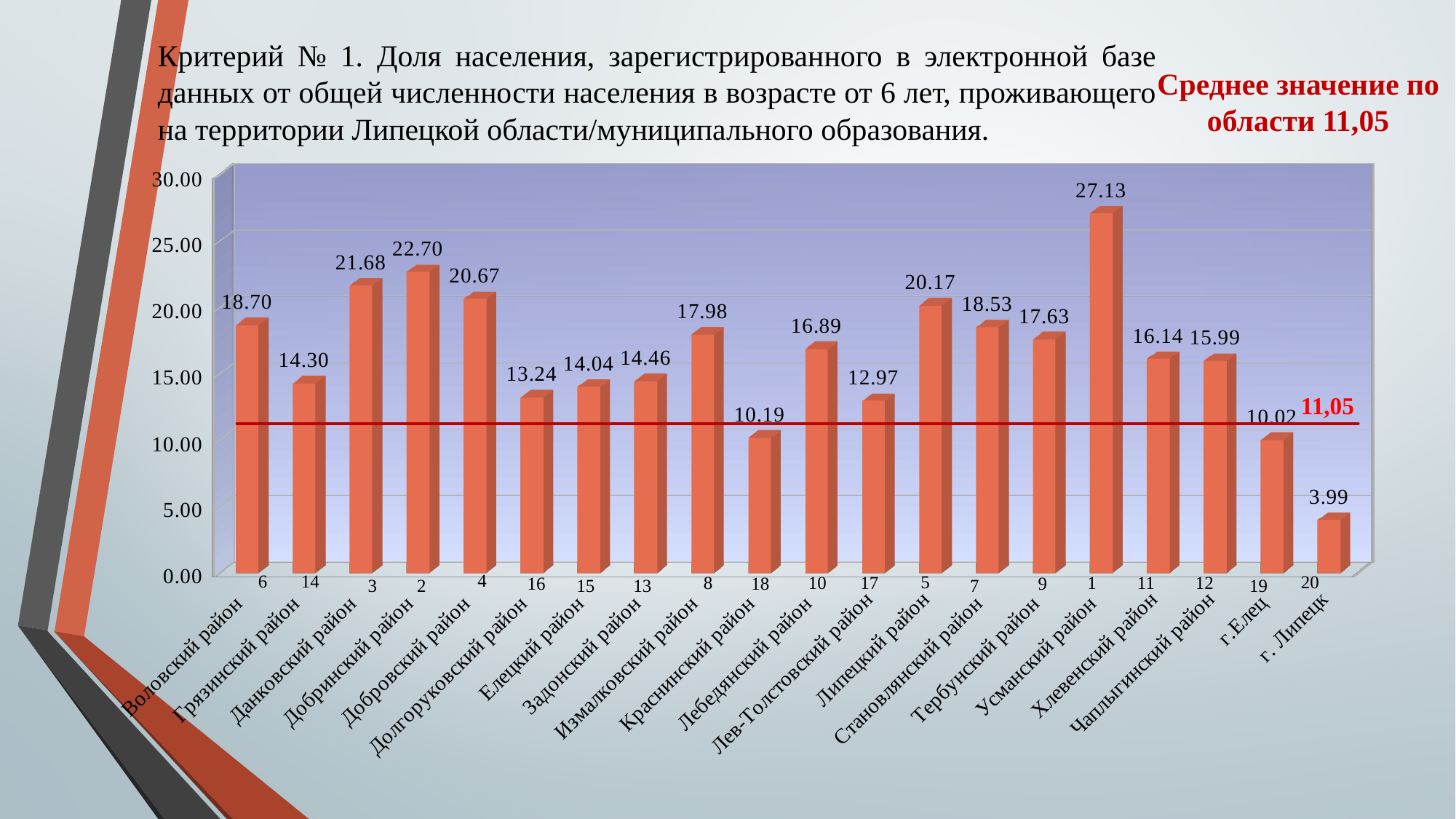
What is the value for Лебедянский район? 16.89 Which category has the lowest value? г. Липецк What is the difference between the values for Добринский район and Данковский район? 1.02 How many categories are shown on the x axis? 20 What is the difference between the values for Усманский район and г. Липецк? 23.14 What kind of chart is shown on the slide? bar chart What is the value for Усманский район? 27.13 Is the value for Краснинский район greater or less than 15.00? less What is the regional average value marked by the horizontal line on the chart? 11,05 Which category has the highest value? Усманский район Which is larger, the value for Воловский район or the value for Становлянский район? Воловский район What is the value for г. Липецк? 3.99